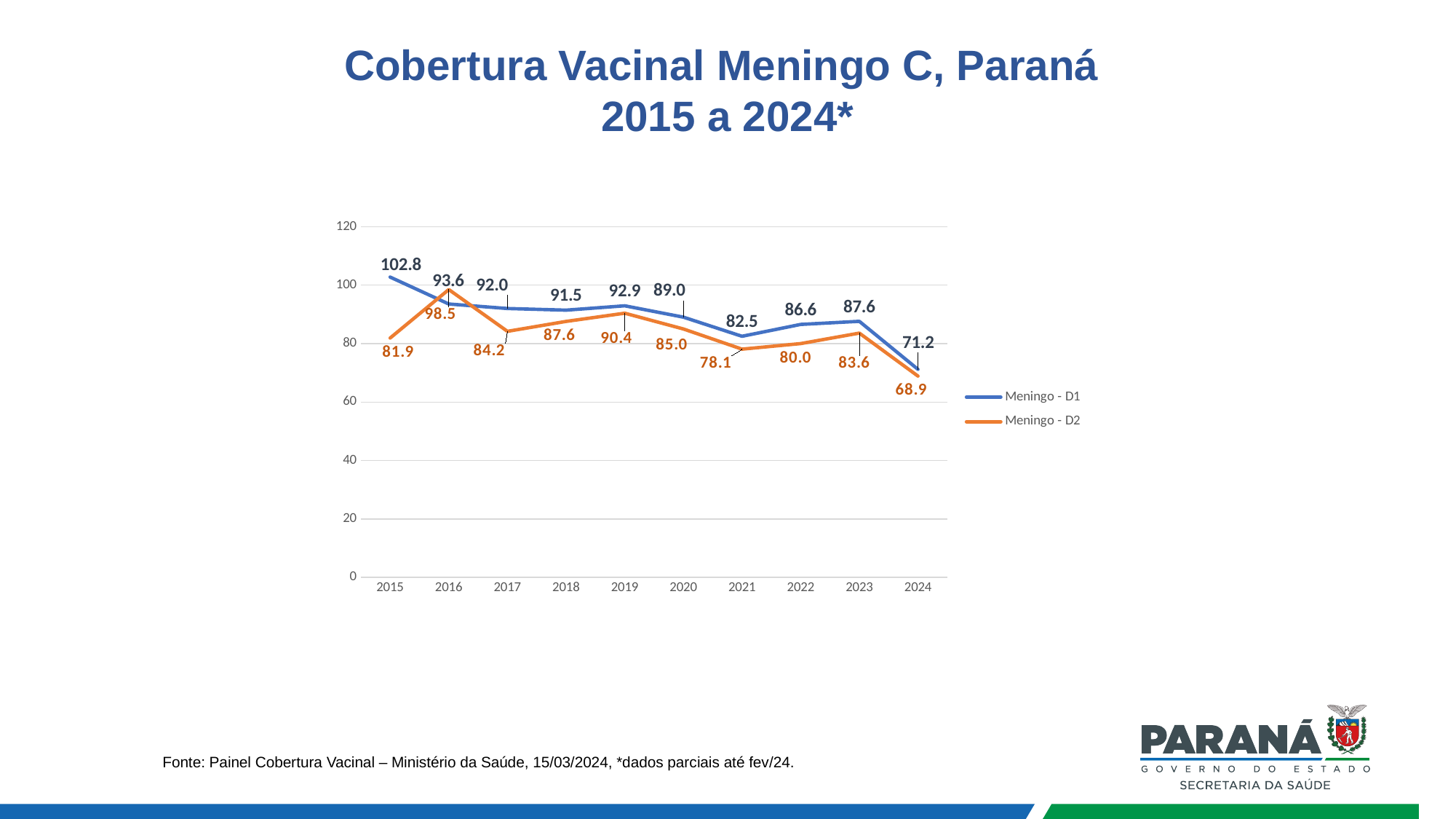
How many years are shown on the x axis? 10 In 2016, which series has the higher value, Meningo - D1 or Meningo - D2? Meningo - D2 How many series does the legend list? 2 What is the value for Meningo - D2 in 2021? 78.1 In which year is Meningo - D2 lowest? 2024 What is the value for Meningo - D2 in 2024? 68.9 In which year is Meningo - D1 highest? 2015 What is the difference between the Meningo - D1 values for 2015 and 2024? 31.6 In which year is Meningo - D2 highest? 2016 What is the value for Meningo - D1 in 2015? 102.8 What kind of chart is shown on the slide? Line chart What is the difference between Meningo - D1 and Meningo - D2 in 2023? 4.0